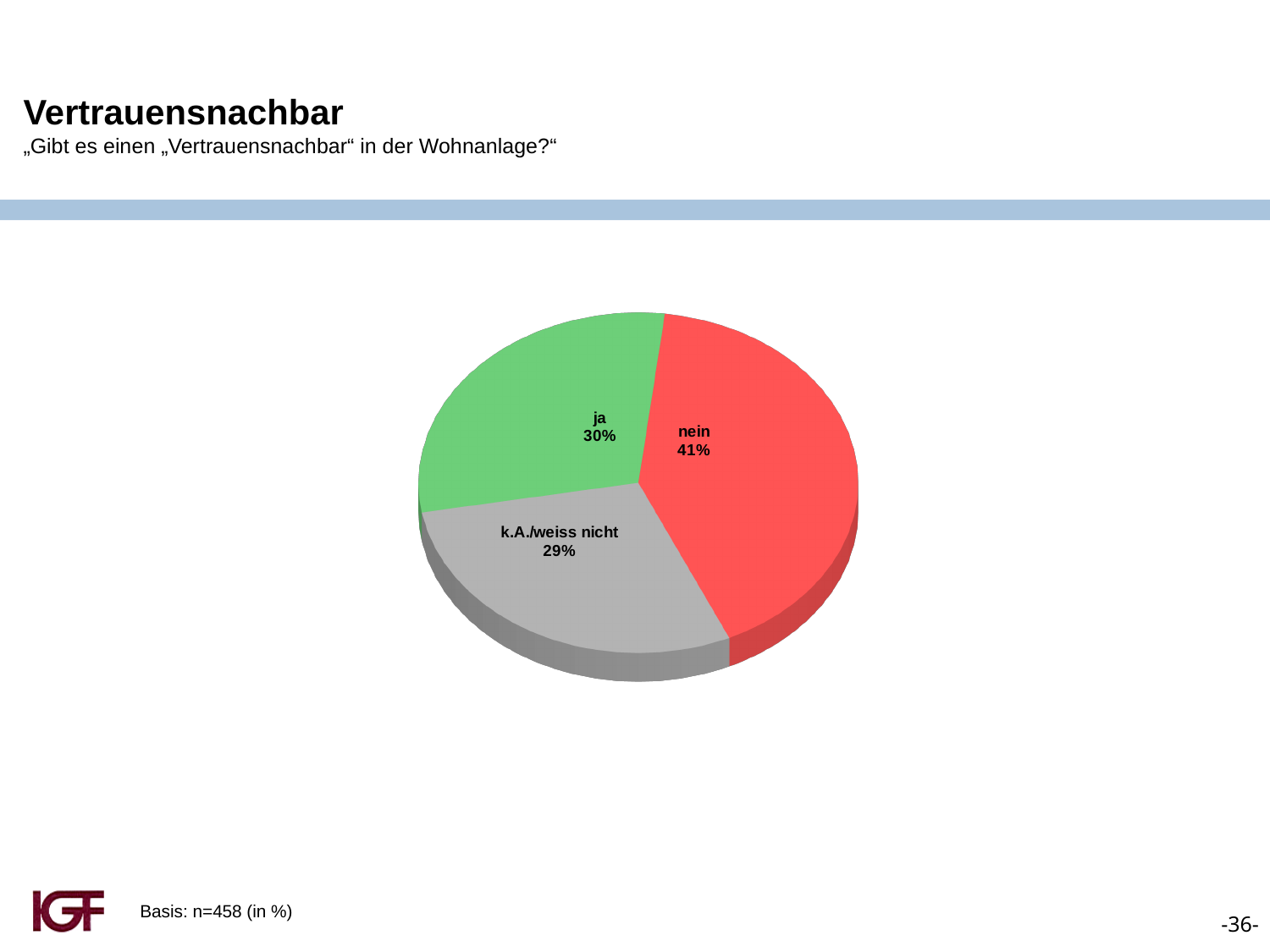
Which slice of the pie is the largest? nein Which slice of the pie is the smallest? k.A./weiss nicht What is the difference in percentage points between the "nein" and "ja" slices? 11 What is the sample size (Basis) stated on the slide? n=458 What is the difference in percentage points between the "ja" and "k.A./weiss nicht" slices? 1 How many slices does the pie chart have? 3 What kind of chart is shown on the slide? pie chart What colour is the "nein" slice? red What share of the pie does "k.A./weiss nicht" represent? 29% What share of the pie does "nein" represent? 41% Which is larger, the "nein" slice or the "ja" slice? nein What share of the pie does "ja" represent? 30%